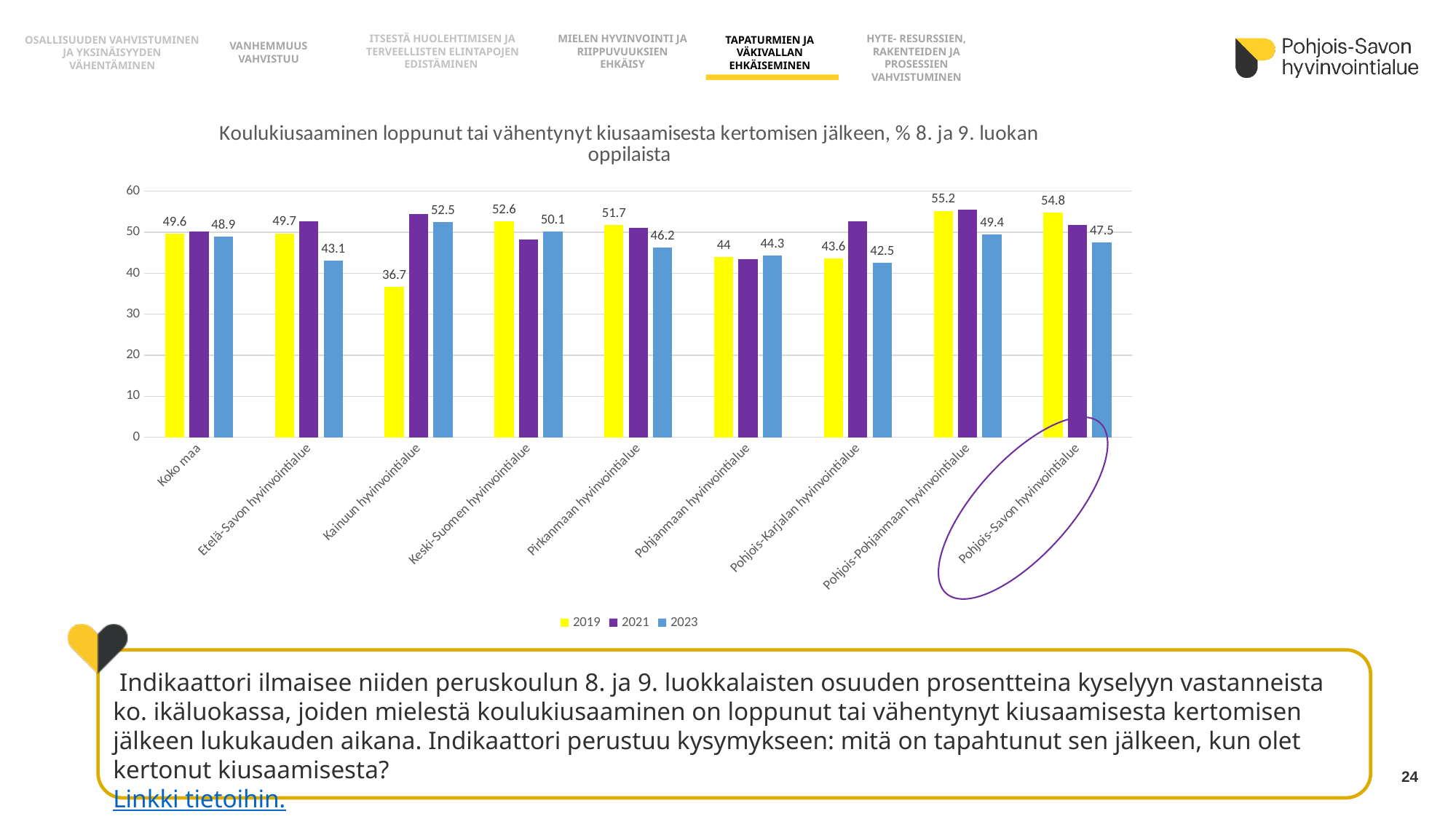
Which category has the lowest 2019 value? Kainuun hyvinvointialue How many categories are shown on the x axis? 9 What kind of chart is shown on the slide? Bar chart Which is larger for Etelä-Savon hyvinvointialue, the 2019 value or the 2023 value? 2019 Is the 2021 value for Kainuun hyvinvointialue greater or less than 50? greater How many series does the legend list? 3 What is the difference between the 2019 and 2023 values for Pohjois-Savon hyvinvointialue? 7.3 What is the 2019 value for Kainuun hyvinvointialue? 36.7 Which category has the highest 2019 value? Pohjois-Pohjanmaan hyvinvointialue What is the 2019 value for Koko maa? 49.6 What is the 2023 value for Pohjois-Savon hyvinvointialue? 47.5 Which category has the highest 2023 value? Kainuun hyvinvointialue